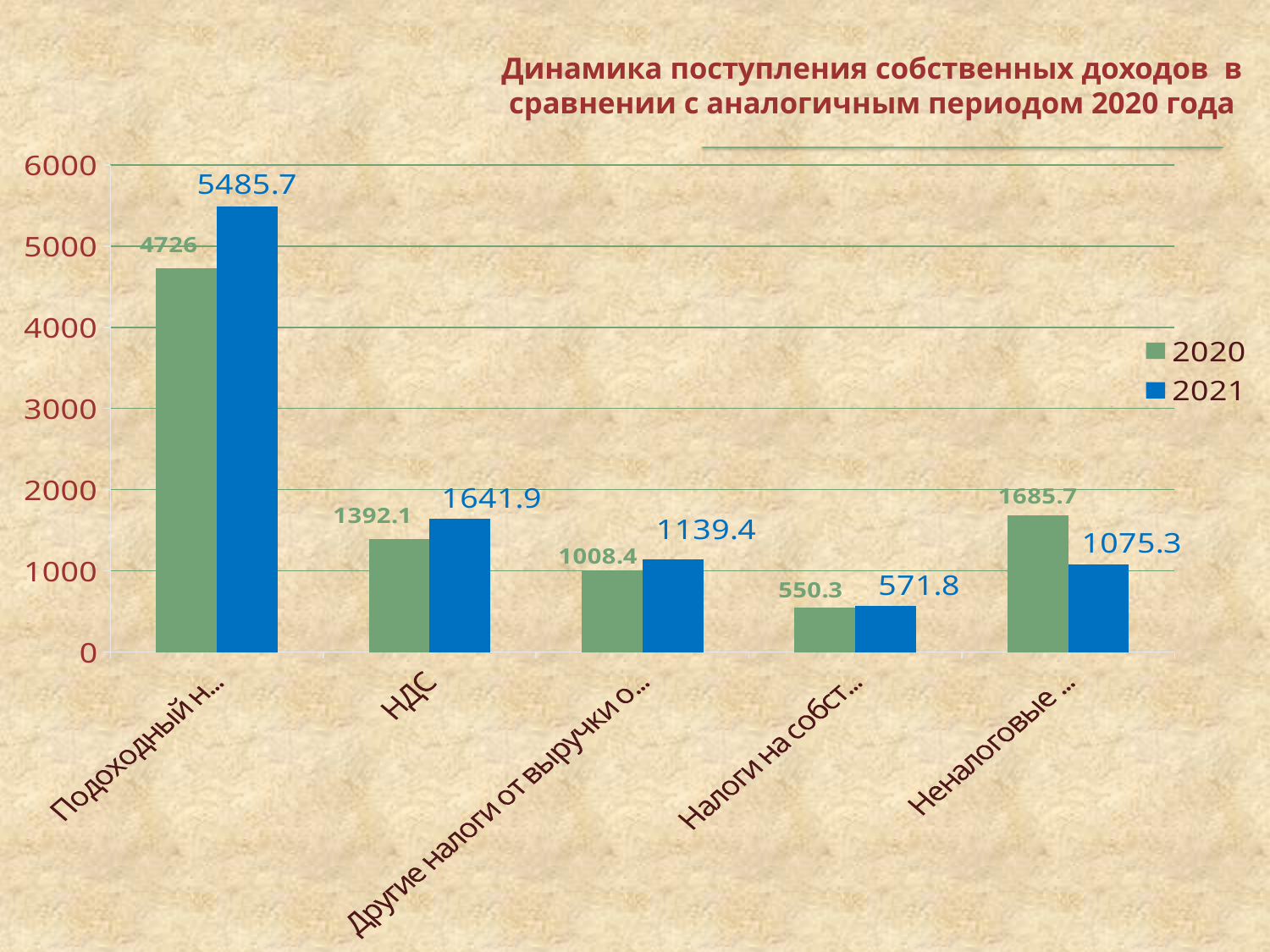
Which category has the highest 2021 value? Подоходный н... What is the difference between the 2021 and 2020 values for the category whose label begins with 'Подоходный'? 759.7 Which colour represents the 2021 series in the legend? Blue How many series does the legend list? 2 What is the 2021 value for НДС? 1641.9 For the category whose label begins with 'Неналоговые', which is larger: the 2020 value or the 2021 value? 2020 What kind of chart is shown on the slide? Bar chart How many categories are shown on the x axis? 5 What is the 2020 value for НДС? 1392.1 What is the 2020 value for the category whose label begins with 'Неналоговые'? 1685.7 Which category has the lowest 2020 value? Налоги на собст... What is the 2021 value for the category whose label begins with 'Подоходный'? 5485.7